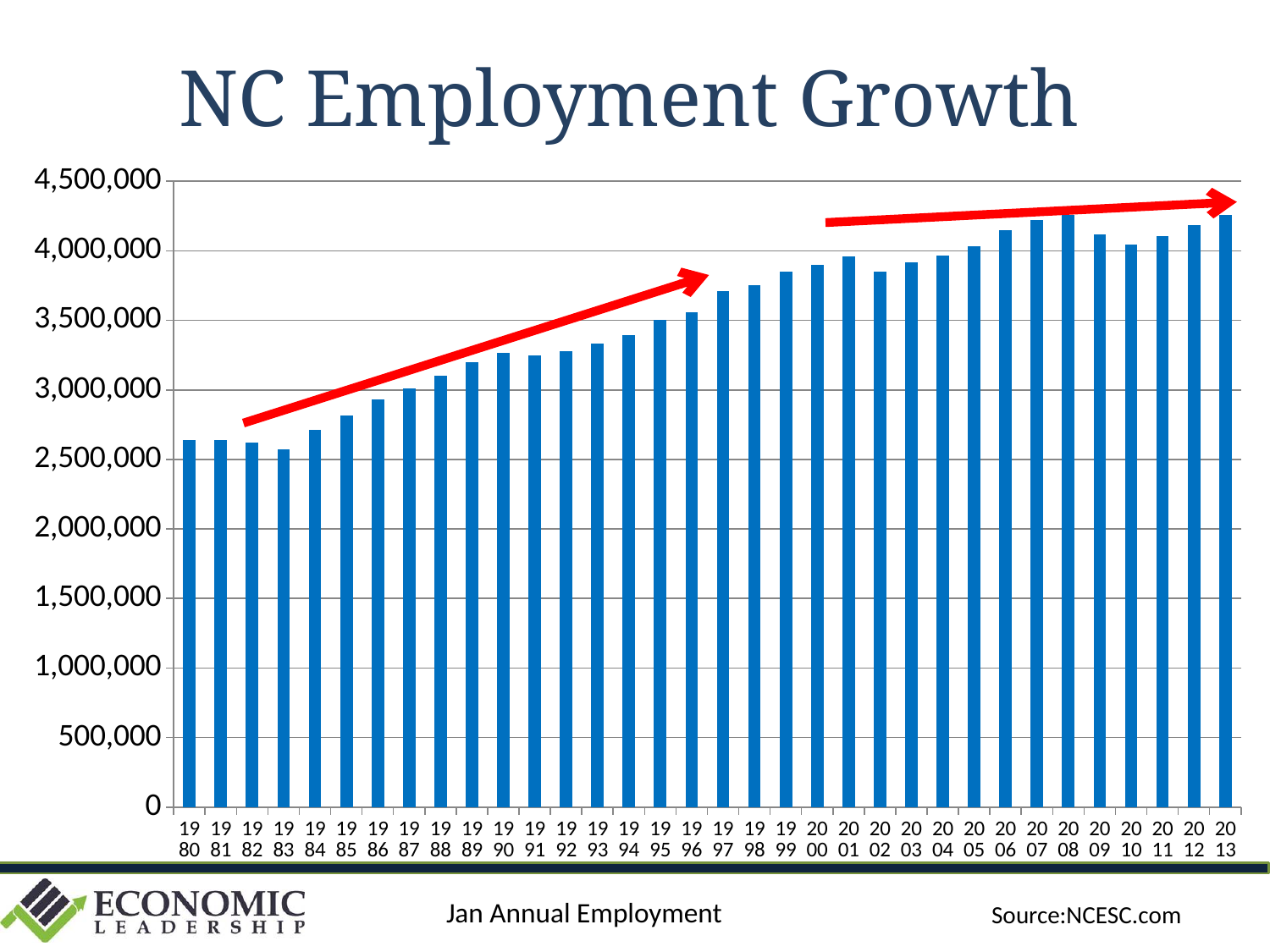
Is the value for 2013 greater or less than 4,000,000? greater How many years (bars) are plotted on the chart? 34 Which year has the larger value, 2001 or 2002? 2001 What is the title of the chart? NC Employment Growth Is the value for 1980 greater or less than 3,000,000? less Is the value for 1994 greater or less than 3,500,000? less Overall, do the employment values rise or fall from 1980 to 2013? rise Which year has the larger value, 2008 or 2010? 2008 What kind of chart is shown on the slide? bar chart What source is cited for the chart data? NCESC.com